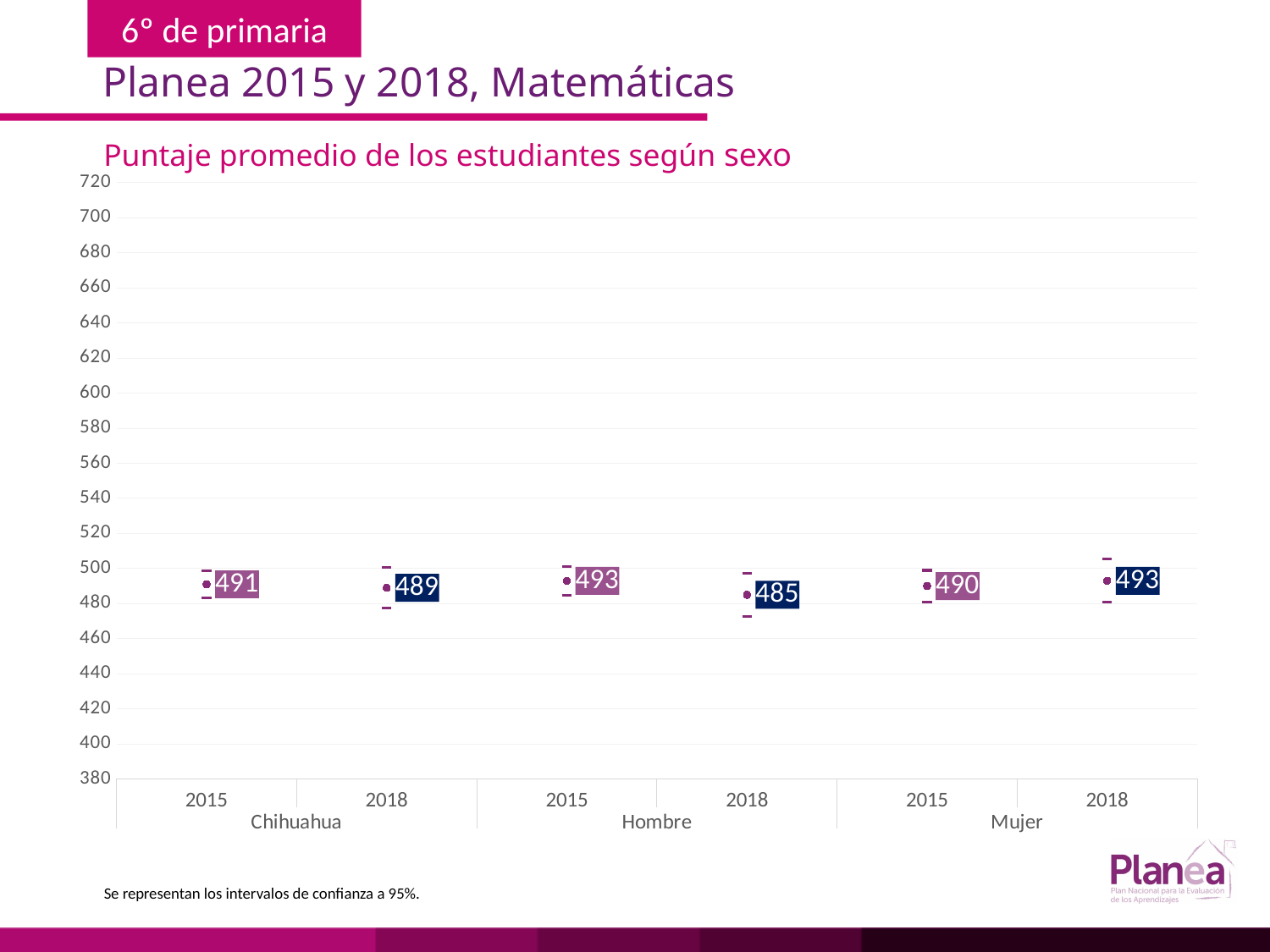
What is the average score for Mujer in 2015? 490 Does the score for Hombre rise or fall from 2015 to 2018? fall Which is larger in 2018, the score for Hombre or for Mujer? Mujer Is the value for Mujer in 2018 greater or less than 500? less How many data points are plotted on the chart? 6 What is the average score for Mujer in 2018? 493 What is the average score for Chihuahua in 2015? 491 What is the title of the chart? Puntaje promedio de los estudiantes según sexo Which group and year has the lowest average score? Hombre 2018 What is the difference between the Chihuahua scores in 2015 and 2018? 2 What is the difference between the Hombre scores in 2015 and 2018? 8 What is the average score for Hombre in 2018? 485